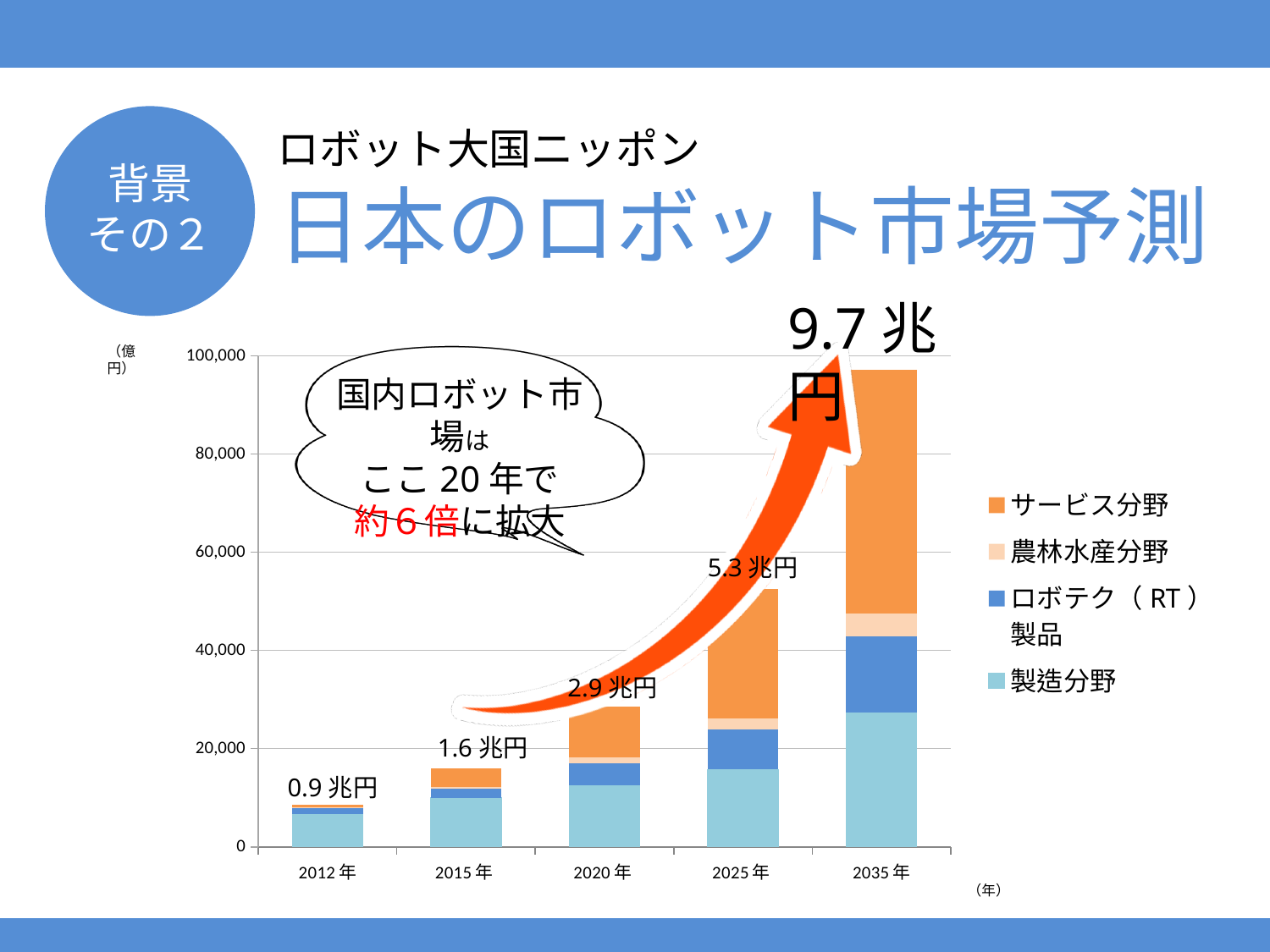
Which year has the highest total market value? 2035年 How many series does the legend list? 4 What kind of chart is shown on the slide? stacked bar chart What is the difference between the labelled totals for 2035年 and 2012年? 8.8兆円 What is the total value labelled for 2035年? 9.7兆円 How many years are shown on the x axis? 5 What is the total value labelled for 2012年? 0.9兆円 Is the 製造分野 segment for 2035年 greater or less than 40,000? less Which year has the lowest total market value? 2012年 Do the total values rise or fall from 2012年 to 2035年? rise Which is larger, the labelled total for 2025年 or for 2015年? 2025年 What is the total value labelled for 2020年? 2.9兆円